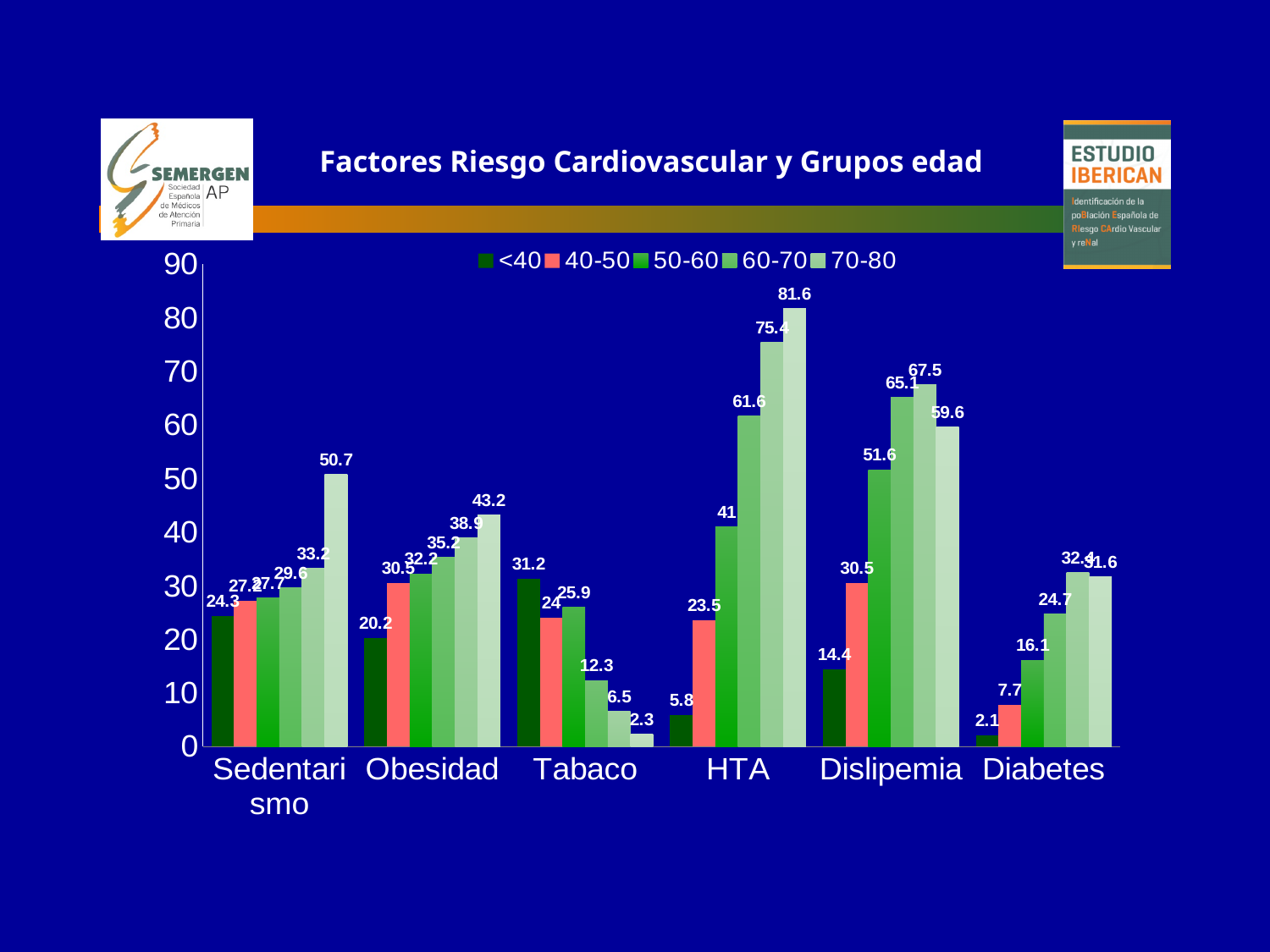
Which is larger for the <40 age group: Tabaco or Sedentarismo? Tabaco What kind of chart is shown on the slide? bar chart What is the difference between the HTA values for the 60-70 and 40-50 age groups? 38.1 Do the HTA values rise or fall from the <40 group to the 70-80 group? rise What is the value for Diabetes in the <40 age group? 2.1 What is the value for HTA in the 40-50 age group? 23.5 How many risk-factor categories are shown on the x axis? 6 What is the value for Tabaco in the <40 age group? 31.2 What is the value for Dislipemia in the 70-80 age group? 67.5 Which category has the lowest value for the <40 age group? Diabetes Which category has the highest value for the 60-70 age group? Dislipemia How many series does the legend list? 5